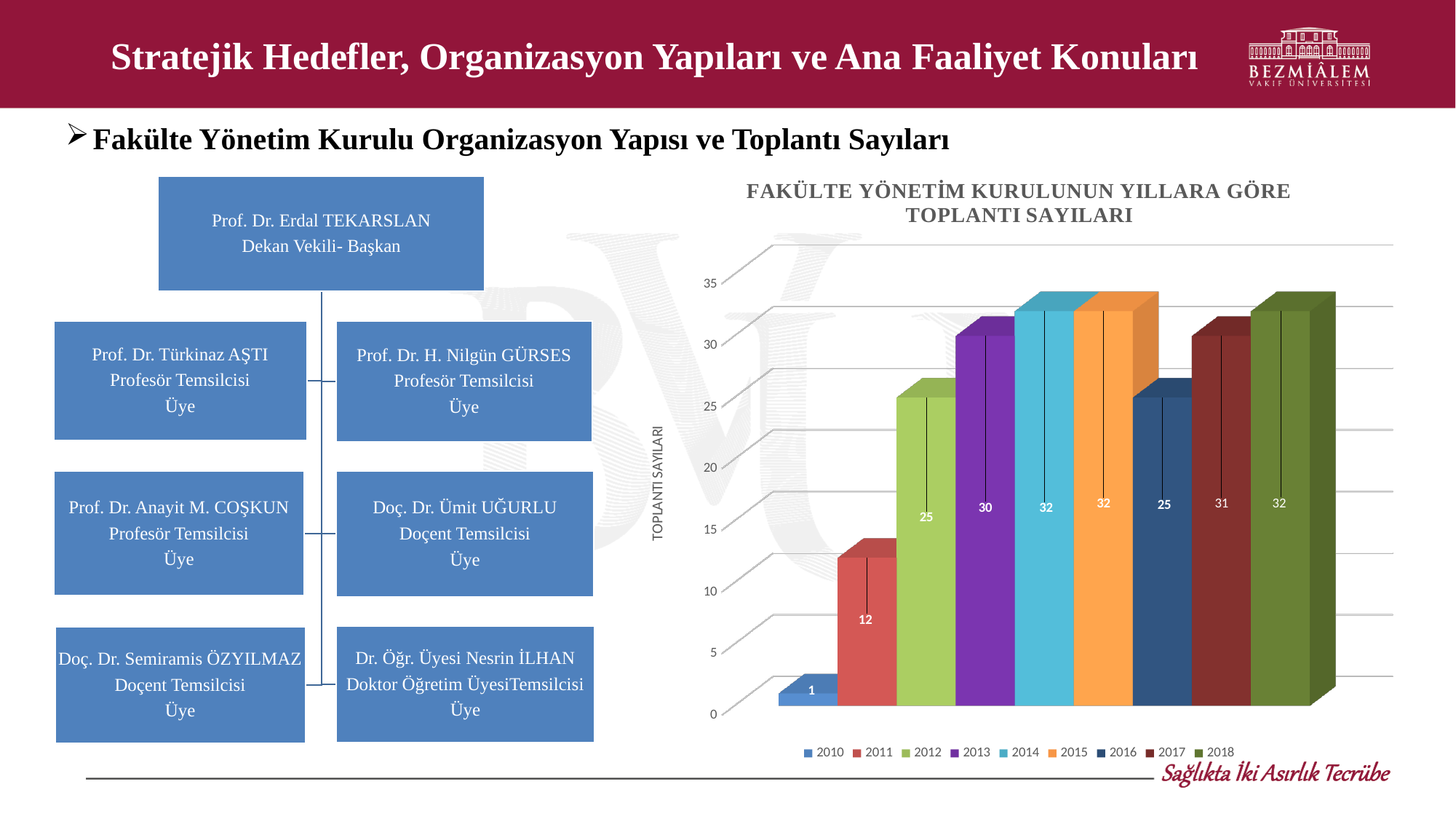
What is the number of meetings shown for 2013? 30 What is the number of meetings shown for 2017? 31 Which year has more meetings, 2013 or 2016? 2013 What kind of chart is shown on the slide? Bar chart How many entries does the legend list? 9 What is the number of meetings shown for 2011? 12 Which year has the lowest number of meetings? 2010 How many years are shown in the chart? 9 What is the difference between the number of meetings in 2014 and in 2016? 7 What is the label on the vertical axis of the chart? TOPLANTI SAYILARI What is the number of meetings shown for 2010? 1 What is the difference between the number of meetings in 2012 and in 2011? 13